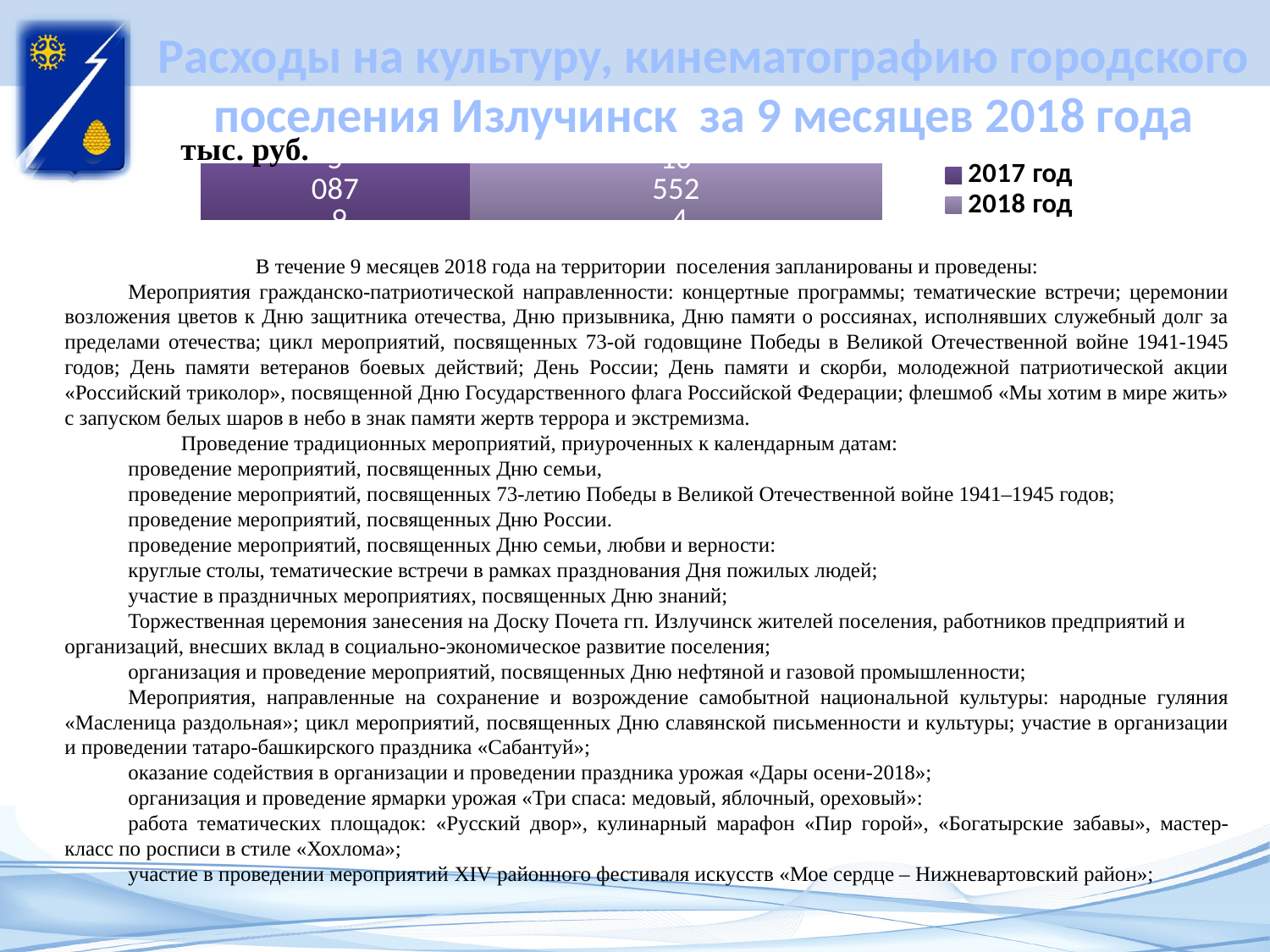
What are the two series named in the chart legend? 2017 год and 2018 год Which year has the larger expenditure on culture and cinematography according to the chart? 2018 год How many series does the chart legend list? 2 Which year has the smaller expenditure on culture and cinematography according to the chart? 2017 год Which series is shown in the darker purple colour in the chart? 2017 год Which series segment is longer in the bar, 2017 год or 2018 год? 2018 год What kind of chart is shown on the slide? bar chart What unit is indicated for the values in the chart? тыс. руб.